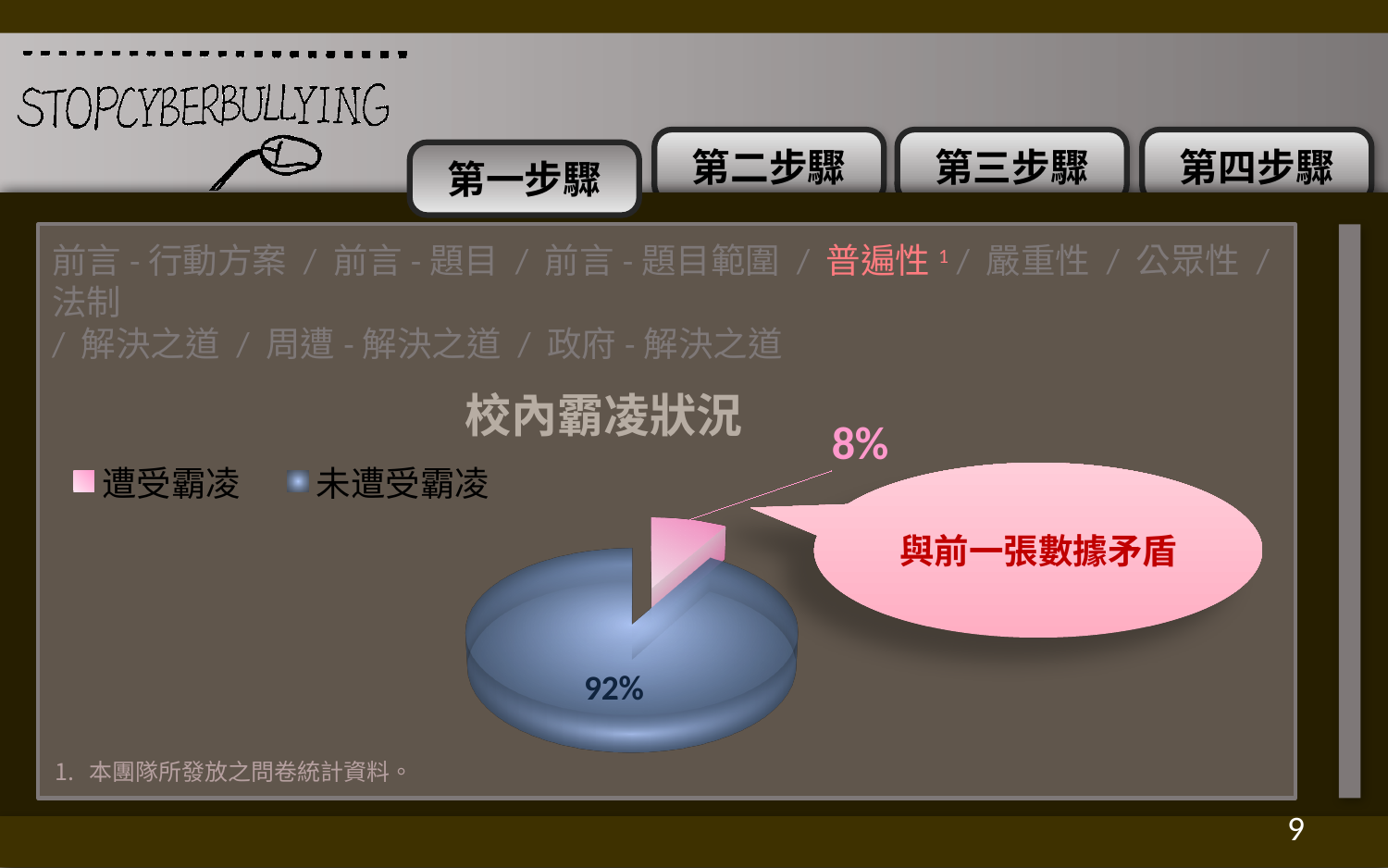
Which slice of the pie is the largest? 未遭受霸凌 What is the difference in percentage points between 未遭受霸凌 and 遭受霸凌? 84 What share of the pie does the 遭受霸凌 slice represent? 8% What colour is the 遭受霸凌 slice in the legend? pink How many slices does the pie chart have? 2 What is the chart's title? 校內霸凌狀況 What percentage is shown for 遭受霸凌? 8% What kind of chart is shown on the slide? pie chart How many entries does the legend list? 2 What percentage is shown for 未遭受霸凌? 92% Which is larger, the share for 遭受霸凌 or the share for 未遭受霸凌? 未遭受霸凌 Which slice of the pie is the smallest? 遭受霸凌